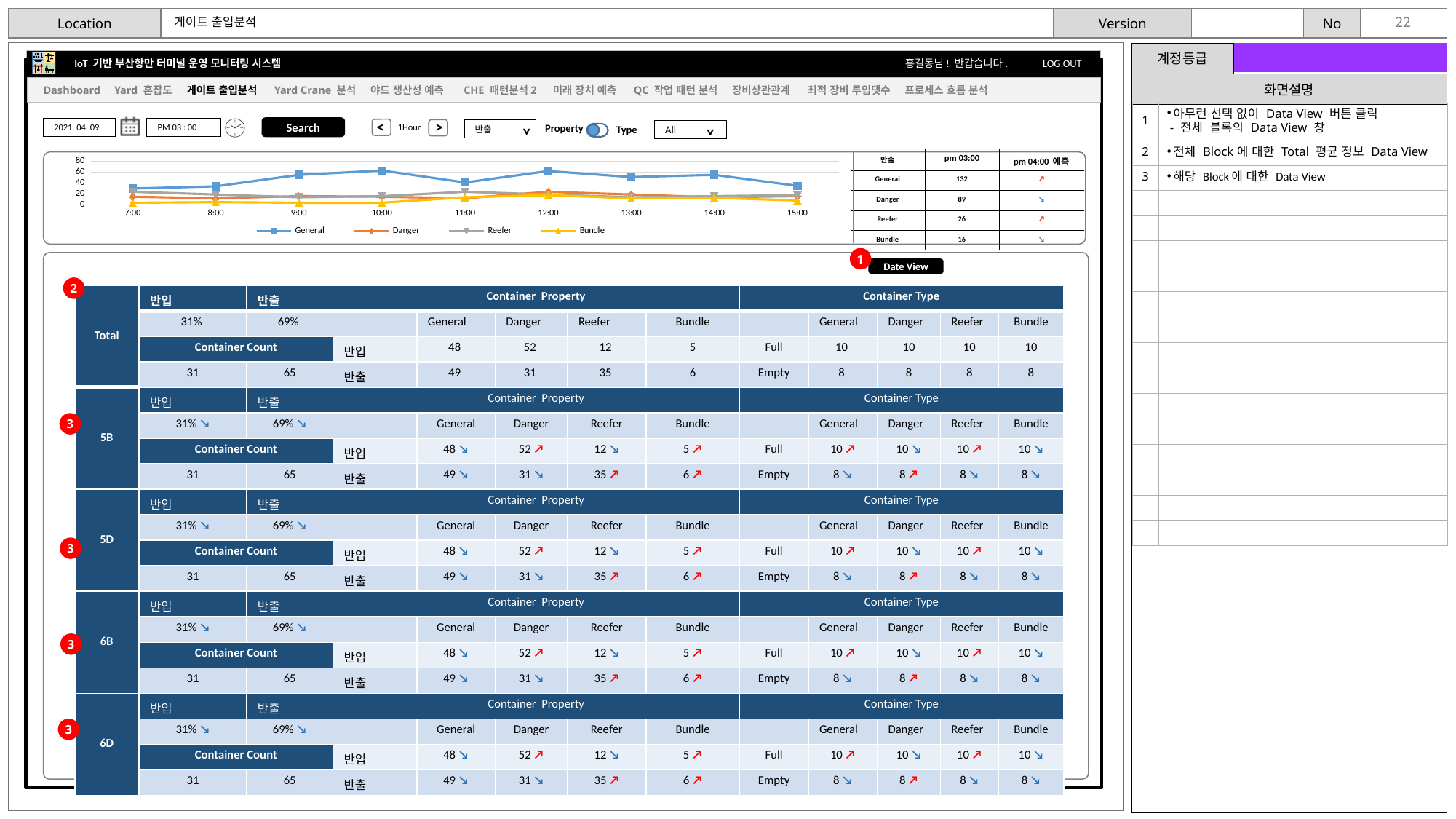
At 7:00, which is larger, Danger or Bundle? Danger Is the value for Bundle at 7:00 greater or less than 20? less At 10:00, which is larger, General or Reefer? General Is the value for General at 10:00 greater or less than 40? greater What kind of chart is shown at the top of the slide? line chart What are the legend entries of the line chart, in order? General, Danger, Reefer, Bundle Which series has the lowest values across the line chart? Bundle How many series does the legend of the line chart list? 4 Is the value for General at 7:00 greater or less than 40? less Which series has the highest values across the line chart? General Does the General series rise or fall from 7:00 to 10:00? rise How many time points are shown along the x axis of the line chart? 9